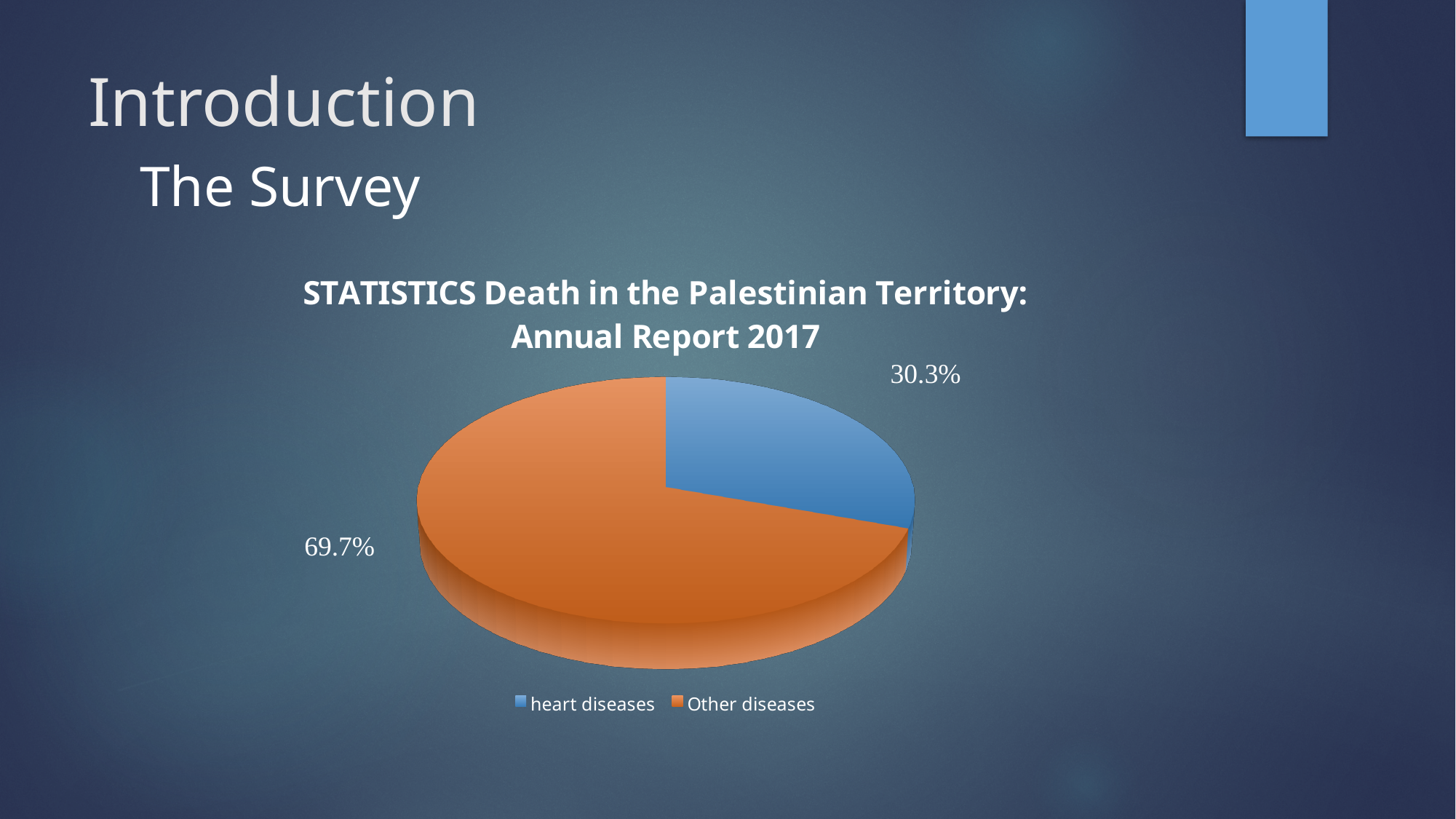
What share of the pie does the heart diseases slice represent? 30.3% What percentage of deaths is attributed to heart diseases? 30.3% Which is larger, the share for heart diseases or the share for Other diseases? Other diseases How many slices does the pie chart have? 2 Which category has the smallest share of the pie? heart diseases What kind of chart is shown on the slide? Pie chart What percentage of deaths is attributed to Other diseases? 69.7% Which category has the largest share of the pie? Other diseases What is the difference in percentage points between Other diseases and heart diseases? 39.4 What is the title of the chart? STATISTICS Death in the Palestinian Territory: Annual Report 2017 How many entries does the legend list? 2 What colour is the slice for Other diseases? Orange